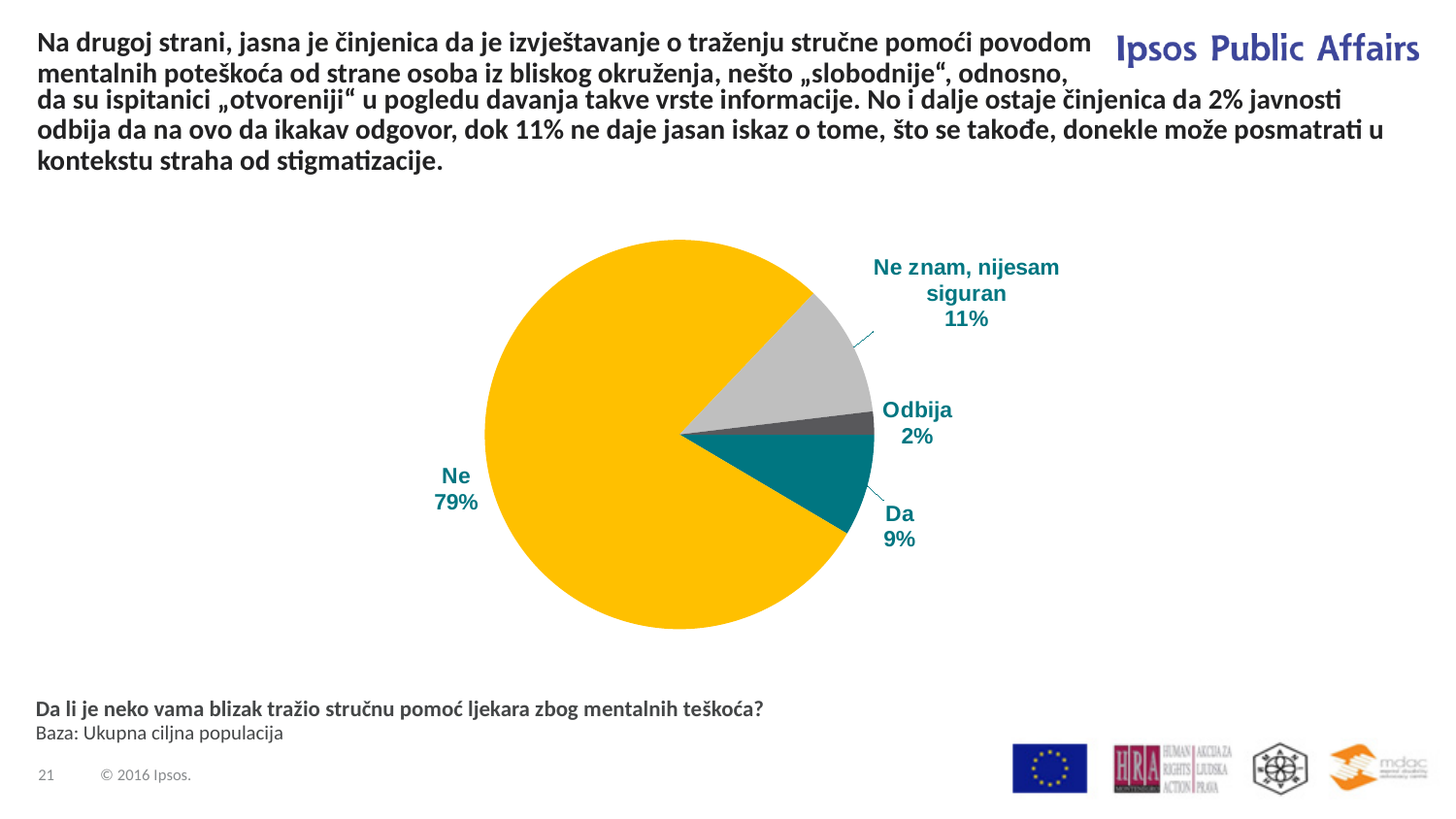
What percentage of respondents answered "Odbija"? 2% How many slices does the pie chart have? 4 Which is larger, the share for "Da" or the share for "Ne znam, nijesam siguran"? Ne znam, nijesam siguran Which category has the smallest share of the pie? Odbija What is the difference in percentage points between "Ne" and "Da"? 70 What colour is the "Ne" slice of the pie? yellow What is the combined share of "Da" and "Odbija"? 11% What kind of chart is shown on the slide? pie chart What percentage of respondents answered "Da"? 9% Which category has the largest share of the pie? Ne What percentage of respondents answered "Ne"? 79% What percentage of respondents answered "Ne znam, nijesam siguran"? 11%